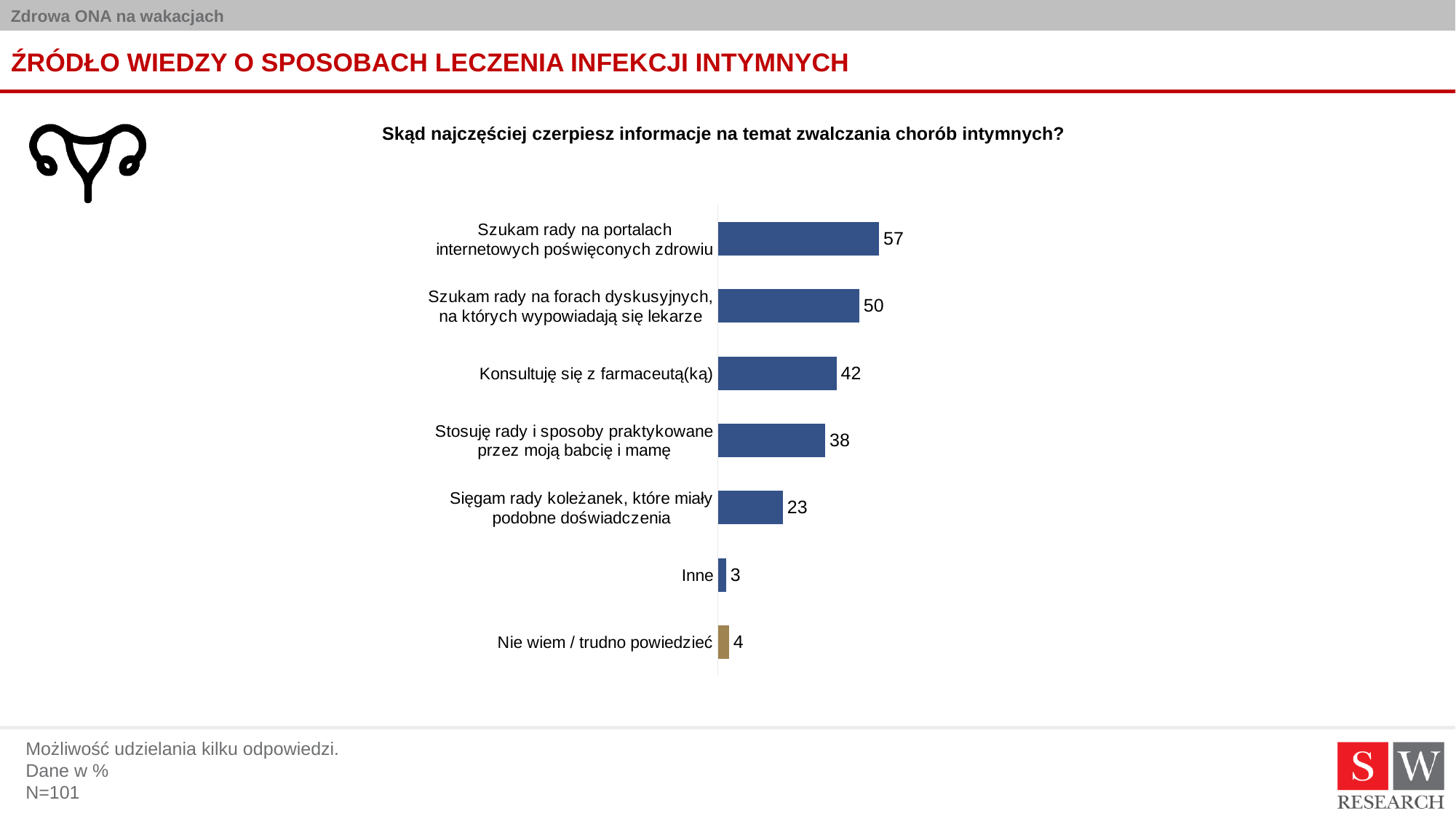
What is the value for "Konsultuję się z farmaceutą(ką)"? 42 What is the value for "Sięgam rady koleżanek, które miały podobne doświadczenia"? 23 Which category has the highest value? Szukam rady na portalach internetowych poświęconych zdrowiu What is the value for "Nie wiem / trudno powiedzieć"? 4 What question is shown as the chart's title? Skąd najczęściej czerpiesz informacje na temat zwalczania chorób intymnych? What kind of chart is shown on the slide? Bar chart What is the difference between the values for "Konsultuję się z farmaceutą(ką)" and "Stosuję rady i sposoby praktykowane przez moją babcię i mamę"? 4 Which category has the lowest value? Inne How many categories are shown in the chart? 7 Which is larger: the value for "Stosuję rady i sposoby praktykowane przez moją babcię i mamę" or for "Sięgam rady koleżanek, które miały podobne doświadczenia"? Stosuję rady i sposoby praktykowane przez moją babcię i mamę What is the difference between the values for "Szukam rady na portalach internetowych poświęconych zdrowiu" and "Szukam rady na forach dyskusyjnych, na których wypowiadają się lekarze"? 7 What is the value for "Szukam rady na portalach internetowych poświęconych zdrowiu"? 57